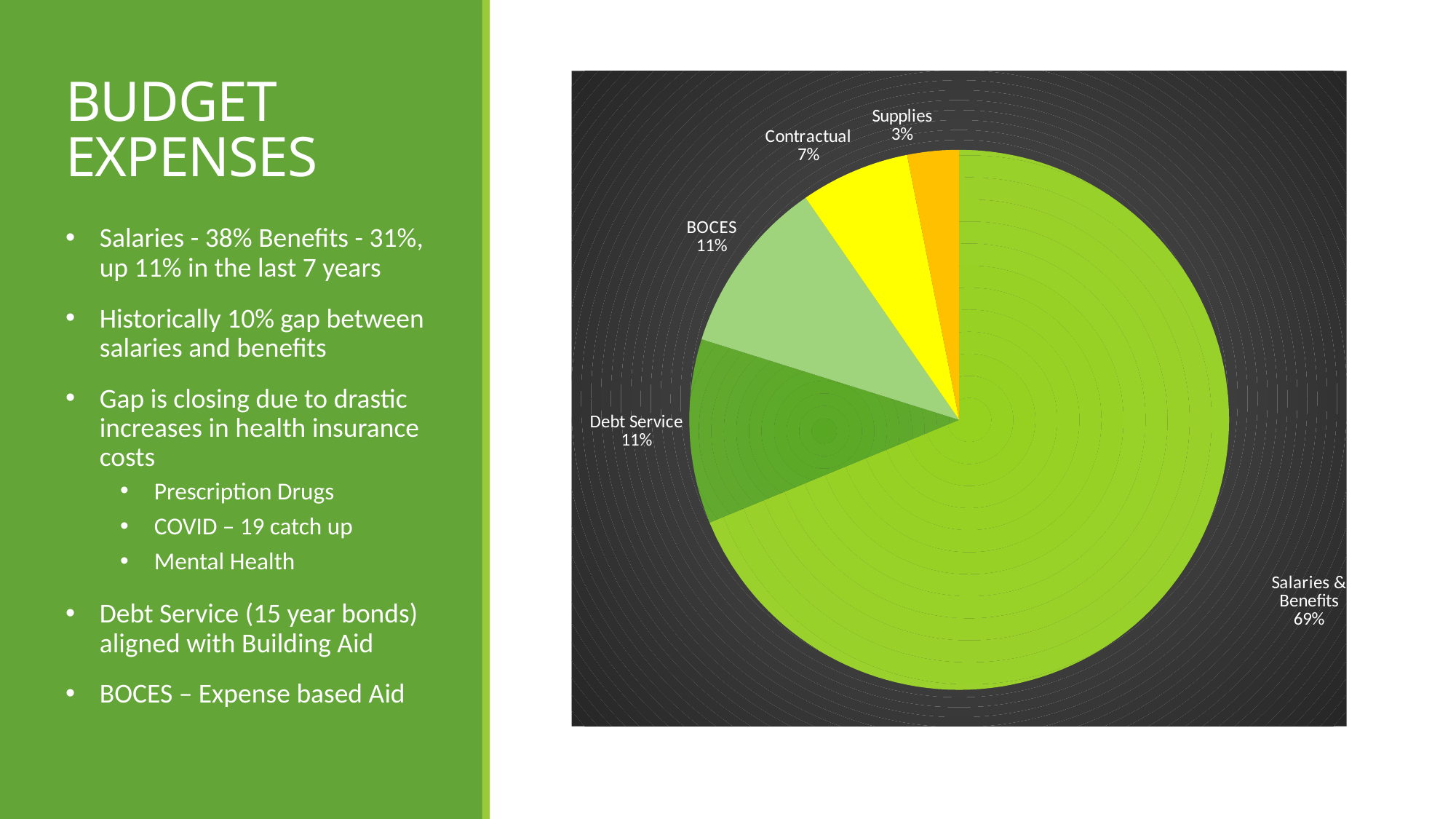
Which category has the largest slice of the pie? Salaries & Benefits How many slices does the pie chart have? 5 What kind of chart is shown on the slide? pie chart What is the value shown for Contractual? 7% What is the value shown for BOCES? 11% Which category has the smallest slice of the pie? Supplies Which is larger, the Contractual slice or the Supplies slice? Contractual What share of the pie does Salaries & Benefits represent? 69% What colour is the Supplies slice? orange What is the difference between the Salaries & Benefits share and the BOCES share? 58% What is the value shown for Debt Service? 11% What is the value shown for Supplies? 3%